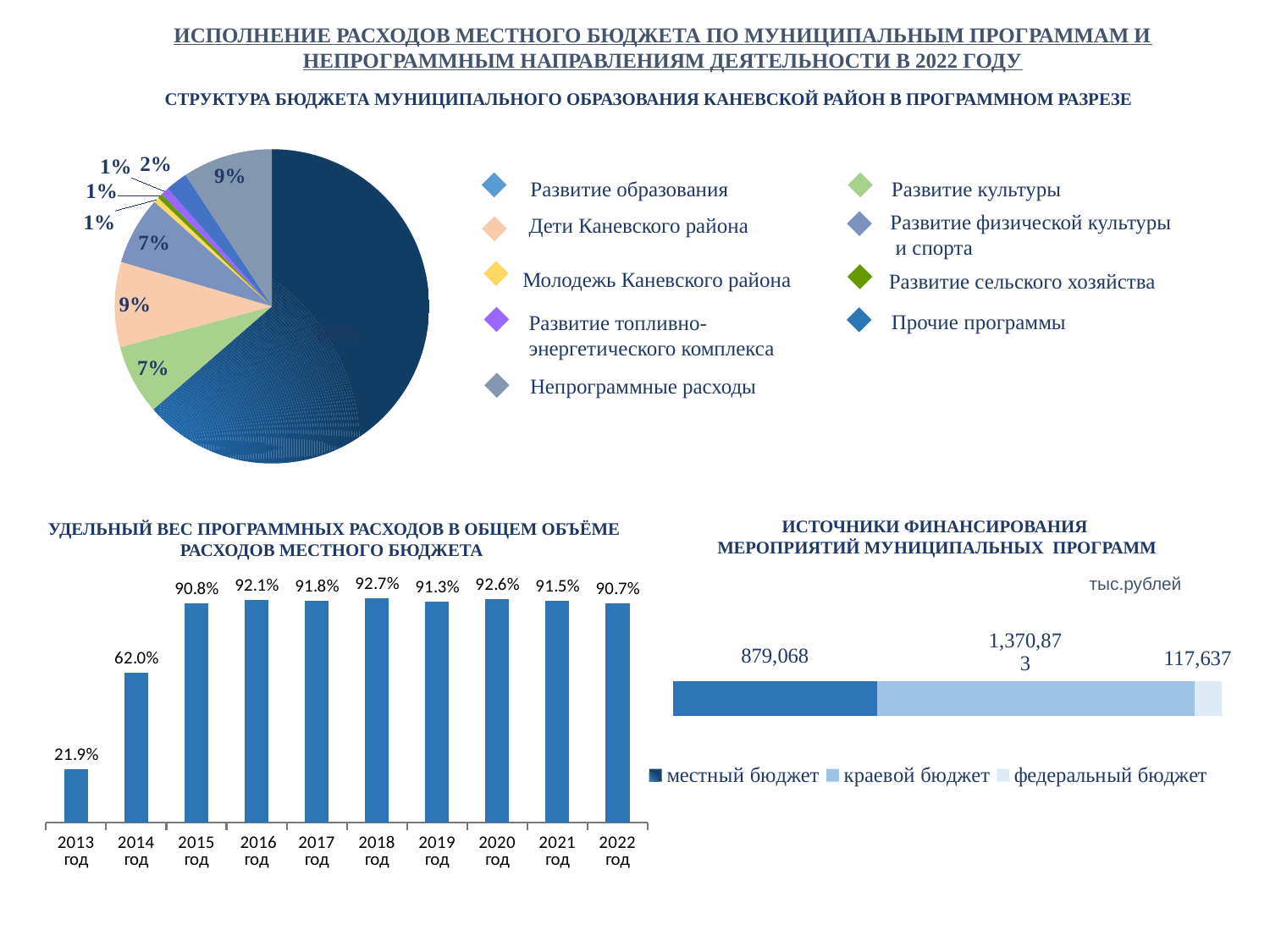
In the bar chart 'Удельный вес программных расходов в общем объёме расходов местного бюджета', which year has the highest value? 2018 год In the bar chart 'Удельный вес программных расходов в общем объёме расходов местного бюджета', what is the value for 2022 год? 90.7% In the chart 'Источники финансирования мероприятий муниципальных программ', what is the value for краевой бюджет? 1,370,873 In the bar chart 'Удельный вес программных расходов в общем объёме расходов местного бюджета', what is the difference between the values for 2014 год and 2013 год? 40.1% In the chart 'Источники финансирования мероприятий муниципальных программ', what is the total of the stacked bar? 2,367,578 In the bar chart 'Удельный вес программных расходов в общем объёме расходов местного бюджета', how many years are shown? 10 In the chart 'Источники финансирования мероприятий муниципальных программ', what is the value for местный бюджет? 879,068 In the bar chart 'Удельный вес программных расходов в общем объёме расходов местного бюджета', what is the value for 2013 год? 21.9% In the bar chart 'Удельный вес программных расходов в общем объёме расходов местного бюджета', which year has the lowest value? 2013 год In the bar chart 'Удельный вес программных расходов в общем объёме расходов местного бюджета', is the value for 2020 год or 2021 год larger? 2020 год In the chart 'Источники финансирования мероприятий муниципальных программ', how many series does the legend list? 3 In the pie chart 'Структура бюджета муниципального образования Каневской район в программном разрезе', what share does Непрограммные расходы have? 9%